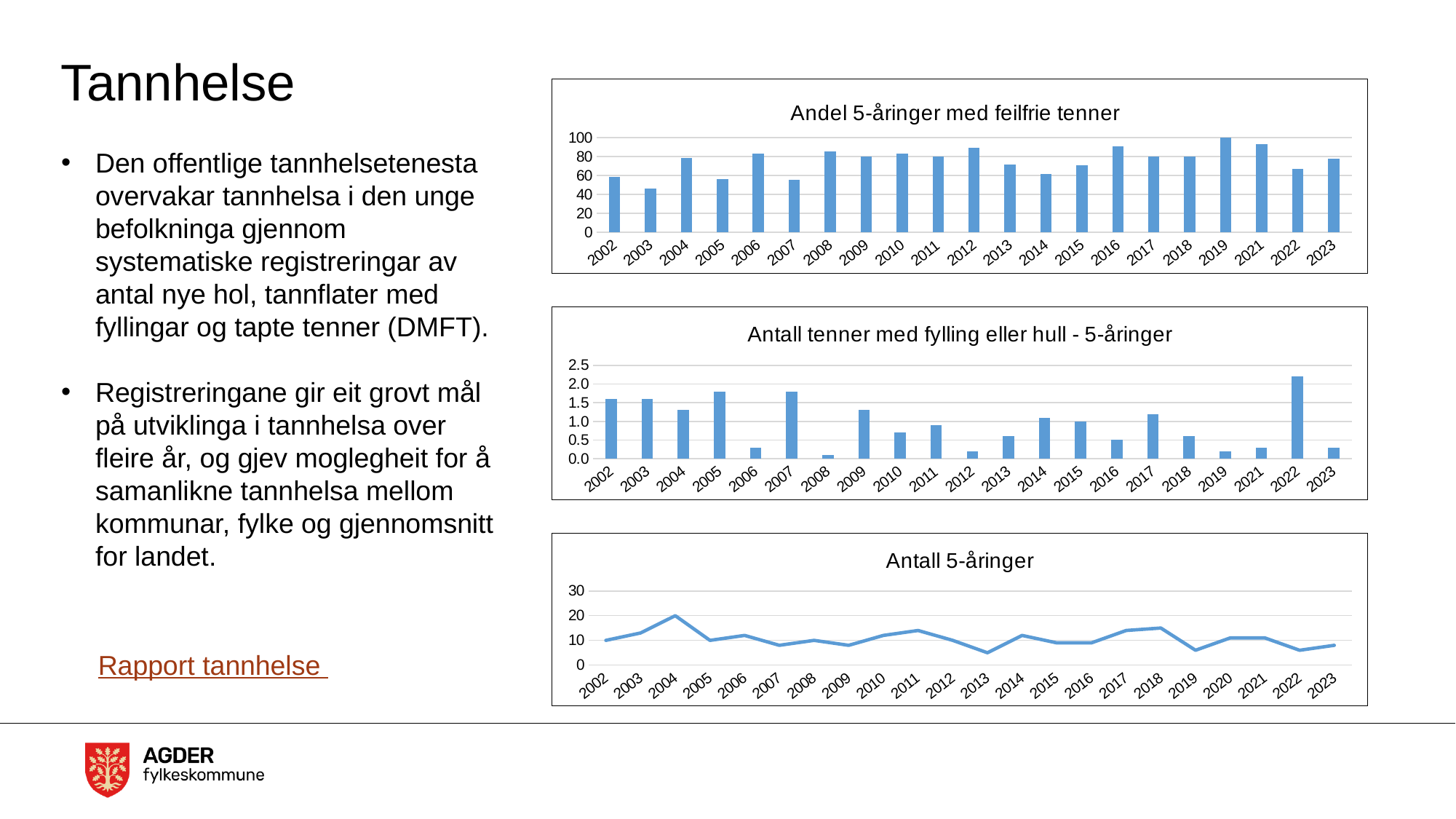
In the 'Antall tenner med fylling eller hull - 5-åringer' chart, which year has the highest value? 2022 What kind of chart is the 'Andel 5-åringer med feilfrie tenner' chart? bar chart In the 'Andel 5-åringer med feilfrie tenner' chart, is the value for 2012 greater or less than 80? greater In the 'Antall tenner med fylling eller hull - 5-åringer' chart, is the value for 2022 greater or less than 2.0? greater In the 'Andel 5-åringer med feilfrie tenner' chart, which year has the lowest value? 2003 In the 'Antall tenner med fylling eller hull - 5-åringer' chart, which year has the lowest value? 2008 In the 'Andel 5-åringer med feilfrie tenner' chart, which year has the highest value? 2019 In the 'Antall tenner med fylling eller hull - 5-åringer' chart, is the value for 2006 greater or less than 0.5? less In the 'Antall 5-åringer' chart, which year has the highest value? 2004 What kind of chart is the 'Antall 5-åringer' chart at the bottom of the slide? line chart